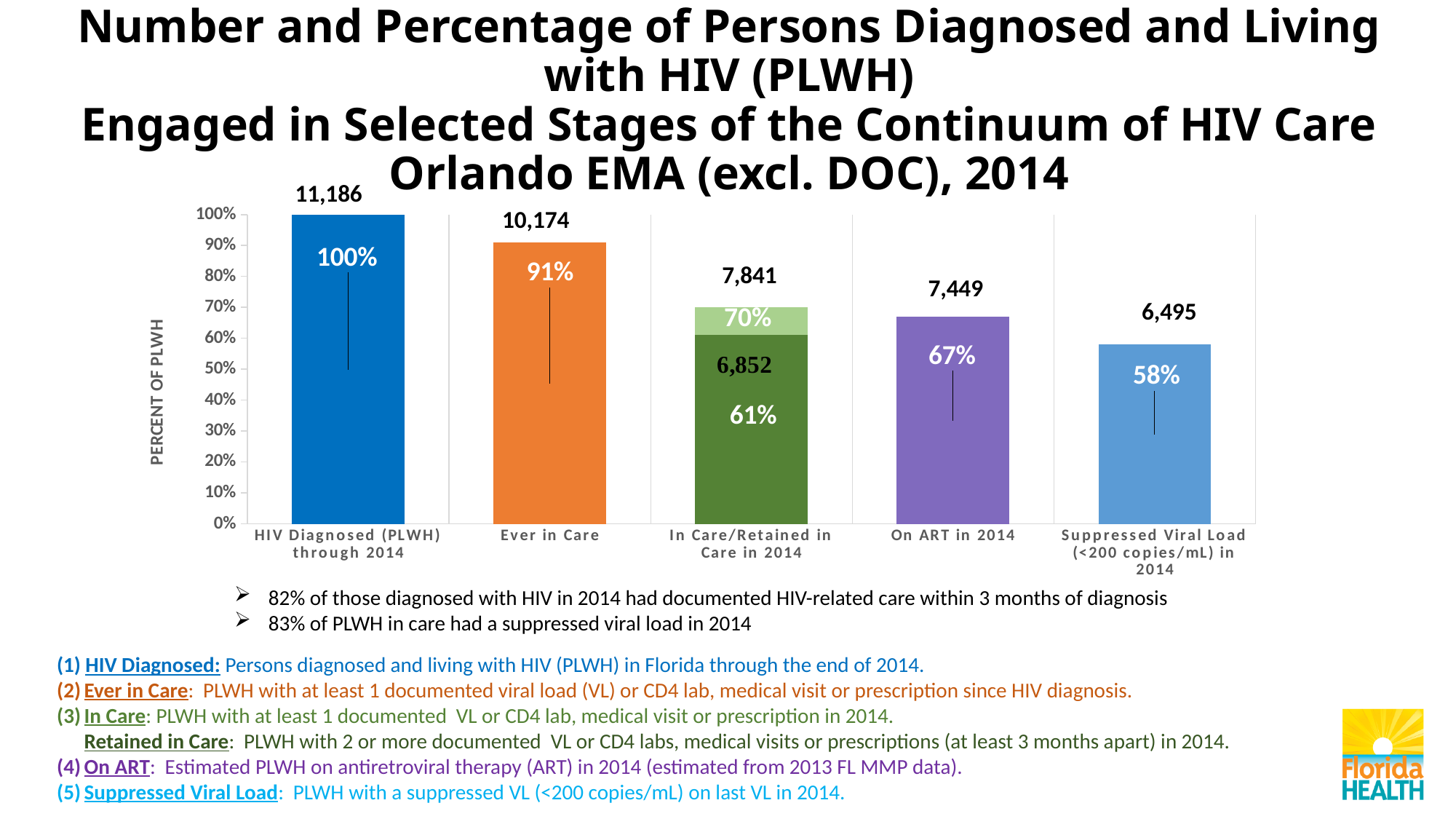
What is the difference in the number of persons between HIV Diagnosed (PLWH) through 2014 and Ever in Care? 1,012 What is the label of the y axis of the chart? PERCENT OF PLWH Which stage of the continuum has the highest number of persons? HIV Diagnosed (PLWH) through 2014 How many persons are shown for On ART in 2014? 7,449 What percentage of PLWH were Ever in Care? 91% What percentage of PLWH had a Suppressed Viral Load (<200 copies/mL) in 2014? 58% What number is shown for Retained in Care in 2014 (the darker green portion of the In Care/Retained in Care bar)? 6,852 Which is larger, the percentage for In Care in 2014 or the percentage for On ART in 2014? In Care in 2014 How many stages (categories) are shown on the x axis of the chart? 5 What type of chart is shown on the slide? Bar chart Which stage of the continuum has the lowest percentage of PLWH? Suppressed Viral Load (<200 copies/mL) in 2014 What is the difference in percentage points between On ART in 2014 and Suppressed Viral Load in 2014? 9